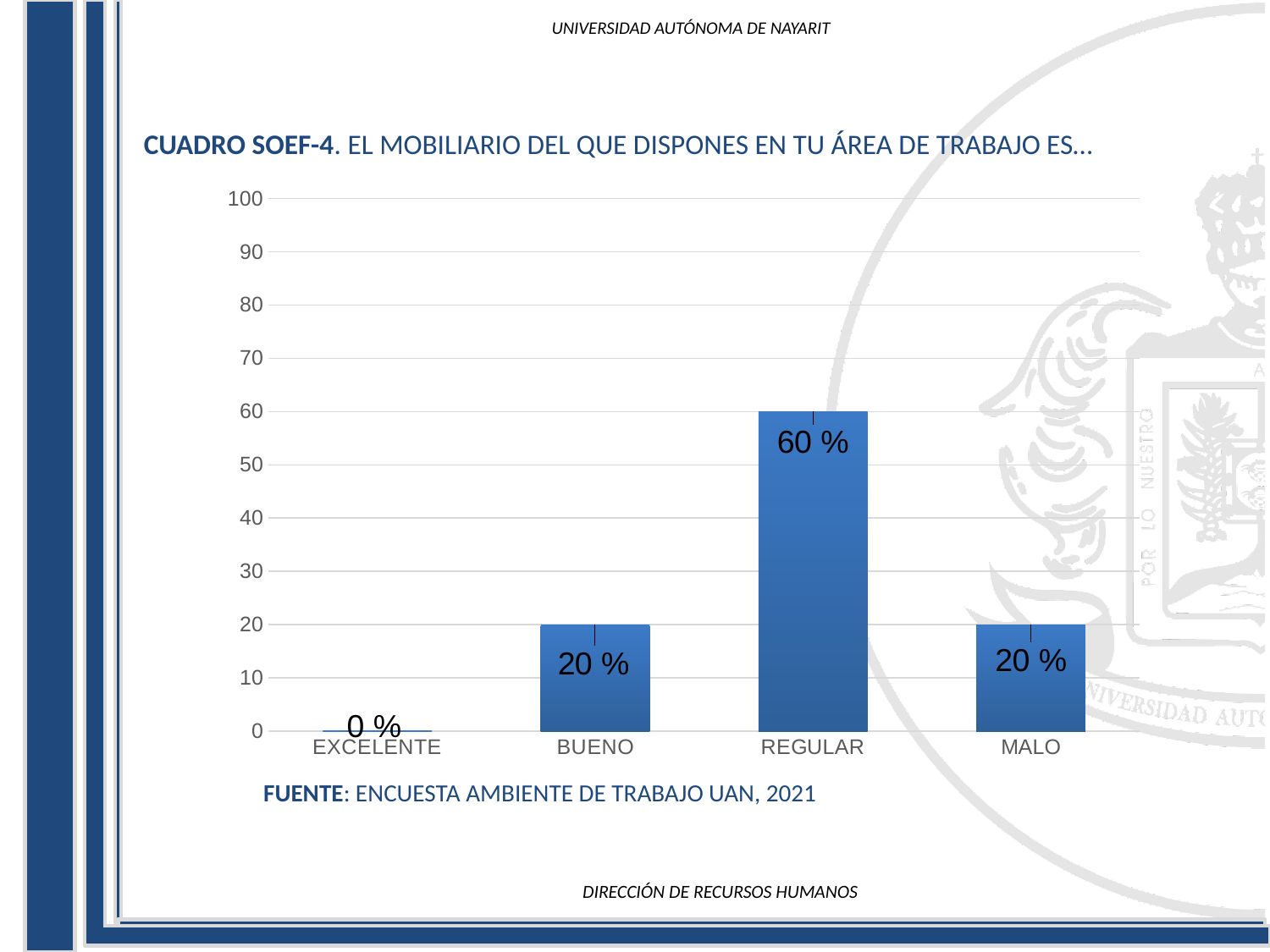
How many categories are shown on the x axis? 4 Is the value for REGULAR greater or less than 50? greater What is the value for EXCELENTE? 0 % What is the value for MALO? 20 % What is the value for REGULAR? 60 % Which is larger, the value for REGULAR or the value for MALO? REGULAR Which category has the highest value? REGULAR Which category has the lowest value? EXCELENTE What is the difference between the values for REGULAR and BUENO? 40 % What source is cited below the chart? ENCUESTA AMBIENTE DE TRABAJO UAN, 2021 What kind of chart is shown on the slide? bar chart What is the value for BUENO? 20 %